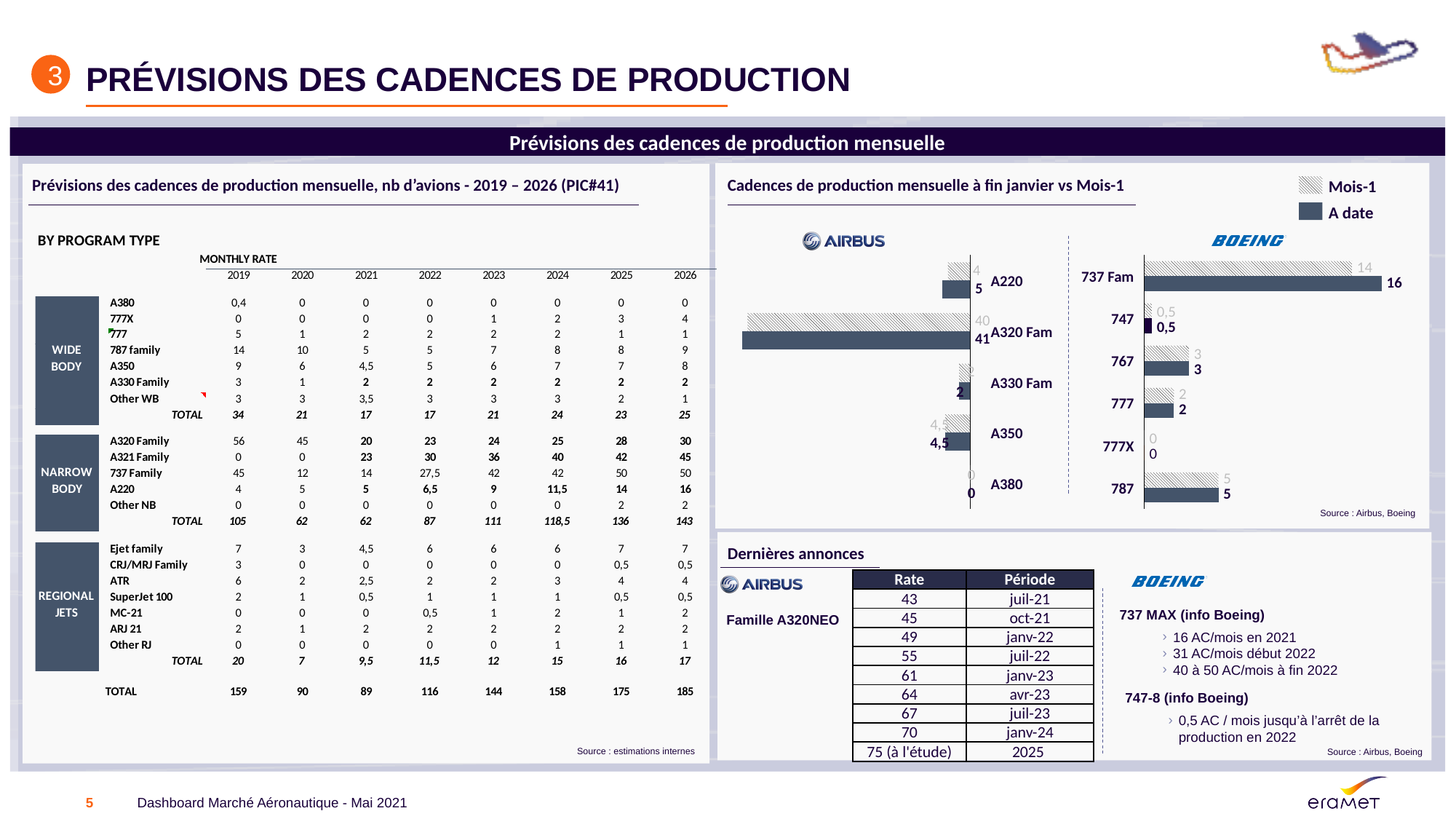
In the chart 'Cadences de production mensuelle à fin janvier vs Mois-1', which Boeing program has the highest 'A date' value? 737 Fam In the chart 'Cadences de production mensuelle à fin janvier vs Mois-1', what is the 'A date' value for the A220? 5 What kind of chart is 'Cadences de production mensuelle à fin janvier vs Mois-1'? Bar chart In the chart 'Cadences de production mensuelle à fin janvier vs Mois-1', what is the difference between the 'A date' and 'Mois-1' values for the 737 Fam? 2 In the chart 'Cadences de production mensuelle à fin janvier vs Mois-1', what is the 'A date' value for the 737 Fam? 16 How many series does the legend of the chart 'Cadences de production mensuelle à fin janvier vs Mois-1' list? 2 In the chart 'Cadences de production mensuelle à fin janvier vs Mois-1', which is larger for the A220: the 'A date' value or the 'Mois-1' value? A date In the chart 'Cadences de production mensuelle à fin janvier vs Mois-1', which Airbus program has the highest 'A date' value? A320 Fam In the chart 'Cadences de production mensuelle à fin janvier vs Mois-1', what is the 'Mois-1' value for the A320 Fam? 40 In the chart 'Cadences de production mensuelle à fin janvier vs Mois-1', what is the 'Mois-1' value for the 737 Fam? 14 In the chart 'Cadences de production mensuelle à fin janvier vs Mois-1', what is the 'A date' value for the 747? 0,5 In the chart 'Cadences de production mensuelle à fin janvier vs Mois-1', what is the 'A date' value for the A320 Fam? 41